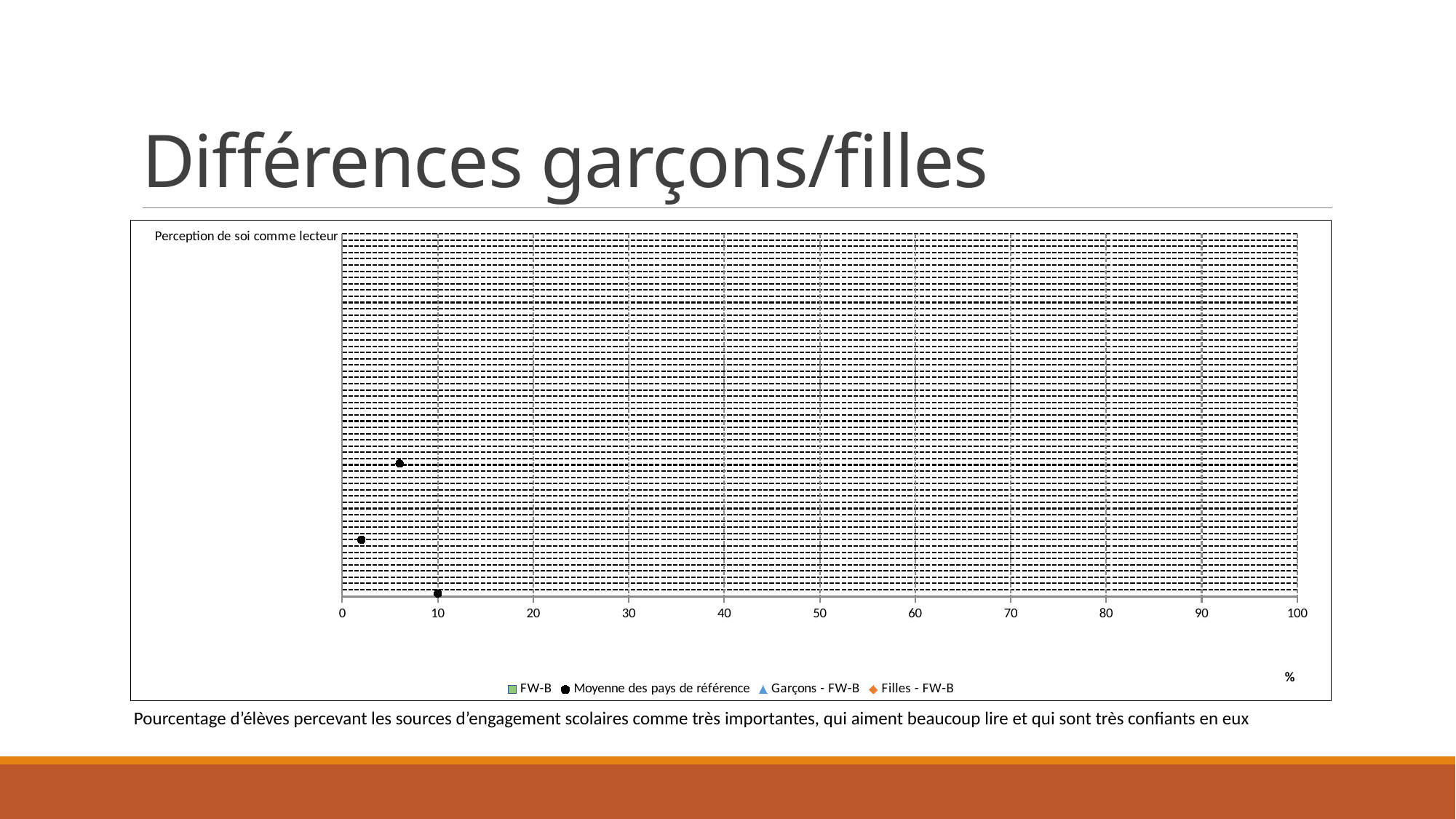
How many series does the legend list? 4 What are the series names listed in the legend? FW-B, Moyenne des pays de référence, Garçons - FW-B, Filles - FW-B How many points are visibly plotted for Moyenne des pays de référence? 3 Are the plotted points for Moyenne des pays de référence greater or less than 20? less What is the interval between consecutive tick labels on the horizontal axis? 10 What unit is indicated at the end of the horizontal axis? % Which category label is readable on the vertical axis of the chart? Perception de soi comme lecteur What is the highest value shown on the horizontal axis? 100 Which legend series is represented by a black circle marker? Moyenne des pays de référence Are the plotted points for Moyenne des pays de référence greater or less than 50? less